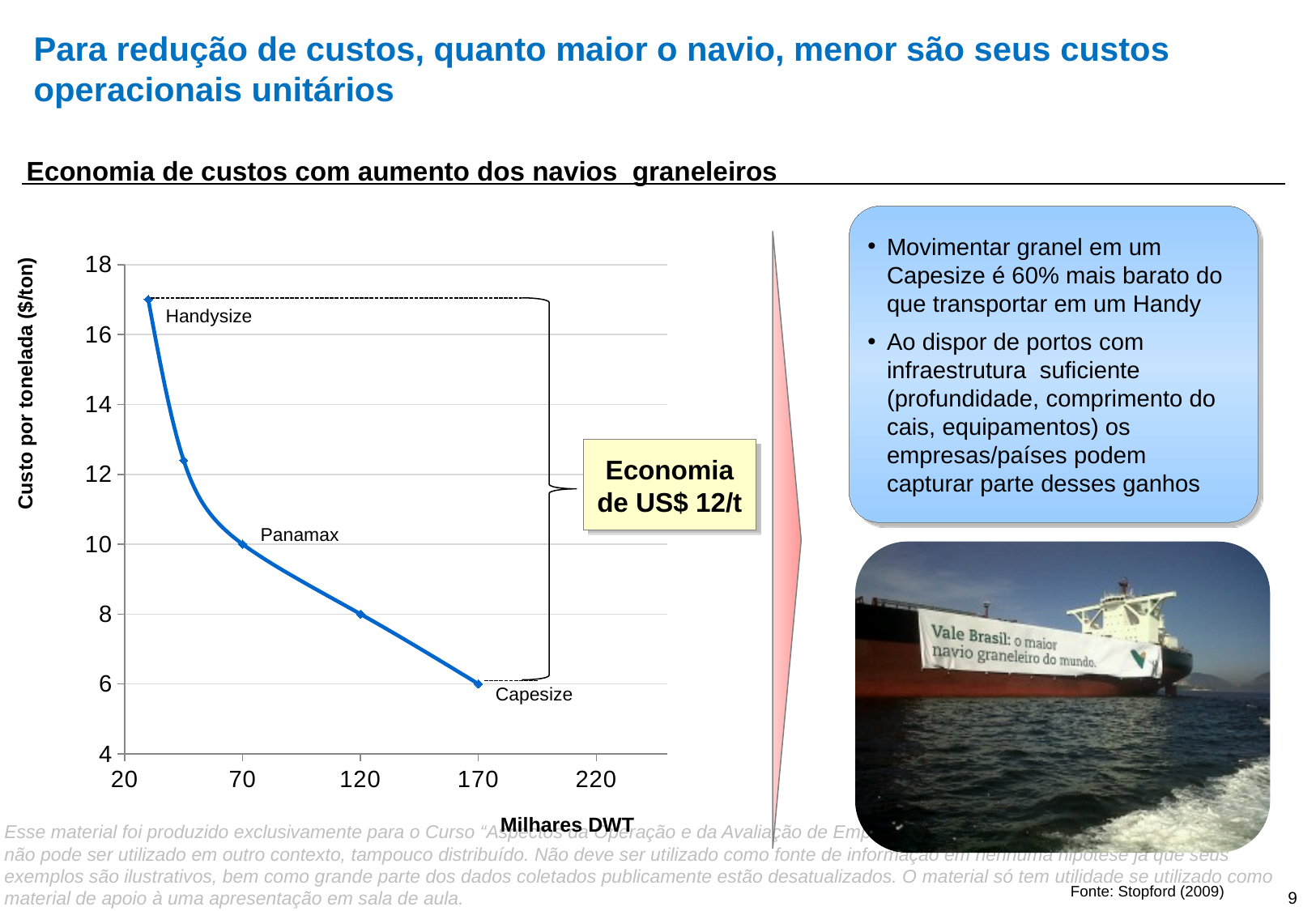
What is the cost per tonne at 120 thousand DWT? 8 Which labelled ship type has the highest cost per tonne? Handysize Which labelled ship type has the lowest cost per tonne? Capesize Does the cost per tonne rise or fall as ship size (thousand DWT) increases? fall What is the difference in cost per tonne between the Panamax point (10) and the Capesize point (6)? 4 What is the cost per tonne for the Capesize point (at 170 thousand DWT)? 6 What kind of chart is shown on the slide? line chart How many data points are plotted on the line? 5 Is the cost per tonne for Handysize greater or less than 16? greater Which has a higher cost per tonne, Panamax or Capesize? Panamax What is the cost per tonne for the Panamax point (at 70 thousand DWT)? 10